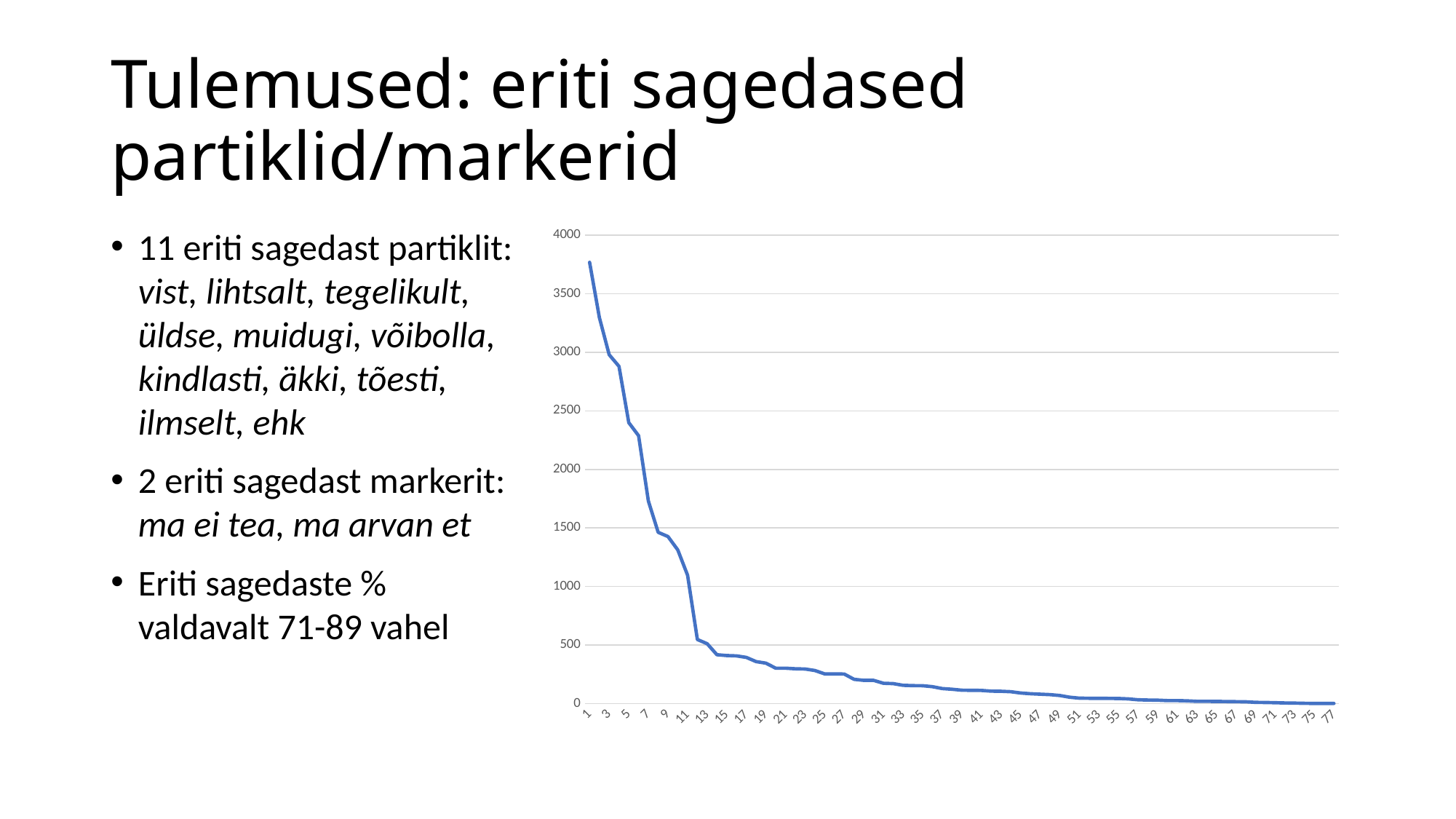
Which has the larger value, point 5 or point 25? point 5 Is the value at point 41 greater or less than 500? less Is the value at point 7 greater or less than 1500? greater Is the value at point 1 greater or less than 3500? greater How many lines are plotted on the chart? 1 What kind of chart is shown on the slide? line chart Which x-axis point has the highest value? 1 Do the values rise or fall as the x axis goes from 1 to 77? fall What is the last x-axis label shown on the chart? 77 What is the highest value shown on the y axis? 4000